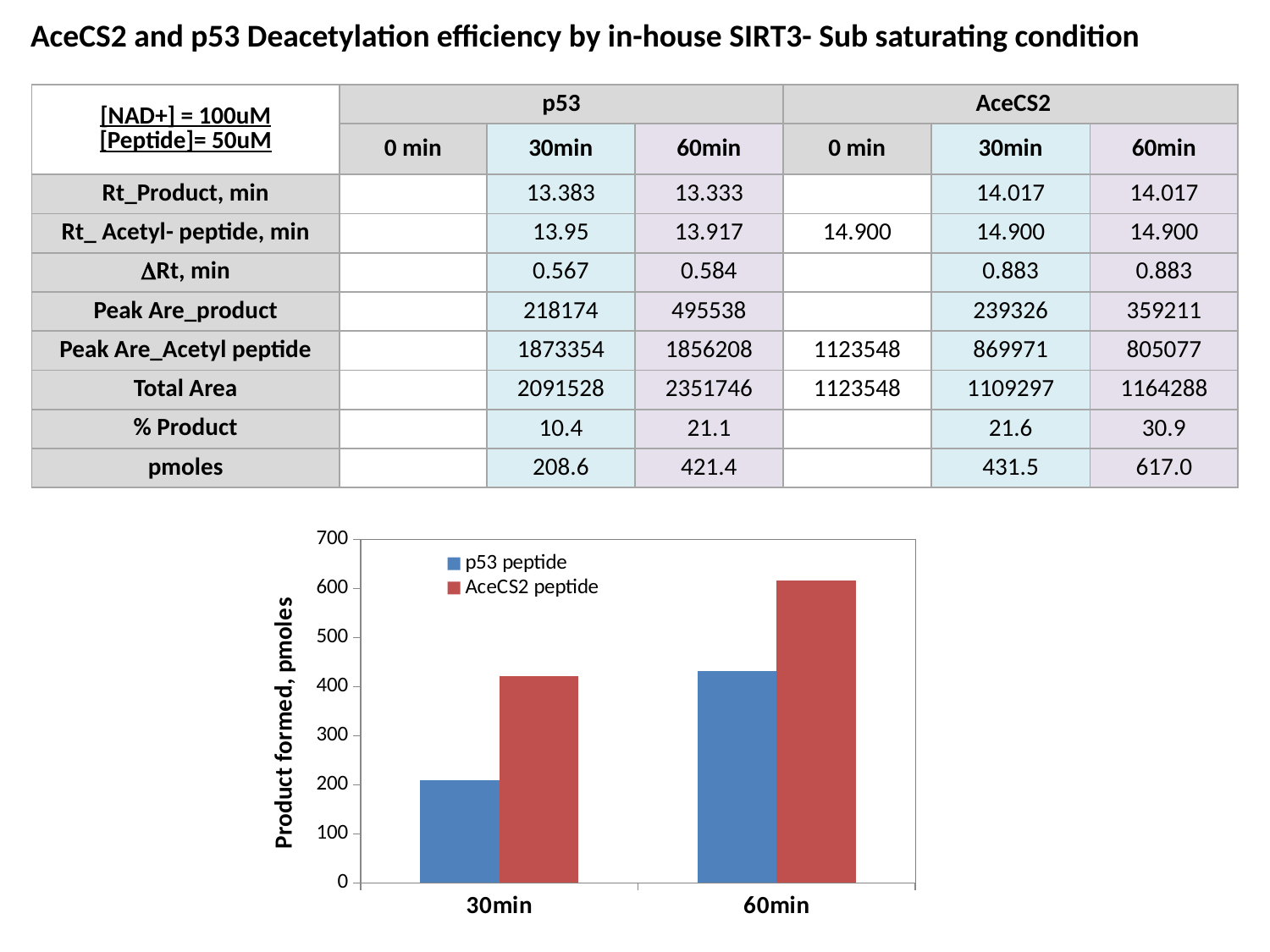
Which series has the tallest bar in the chart? AceCS2 peptide Which bar is the lowest in the chart? p53 peptide at 30min How many series does the chart legend list? 2 Is the value for p53 peptide at 60min greater or less than 400? greater At 60min, which series has the larger value, p53 peptide or AceCS2 peptide? AceCS2 peptide Do the values for p53 peptide rise or fall from 30min to 60min? rise At 30min, which series has the larger value, p53 peptide or AceCS2 peptide? AceCS2 peptide Is the value for AceCS2 peptide at 60min greater or less than 500? greater Is the value for p53 peptide at 30min greater or less than 300? less How many time-point categories are shown on the x axis of the chart? 2 What kind of chart is shown on the slide? bar chart What is the label on the y axis of the chart? Product formed, pmoles